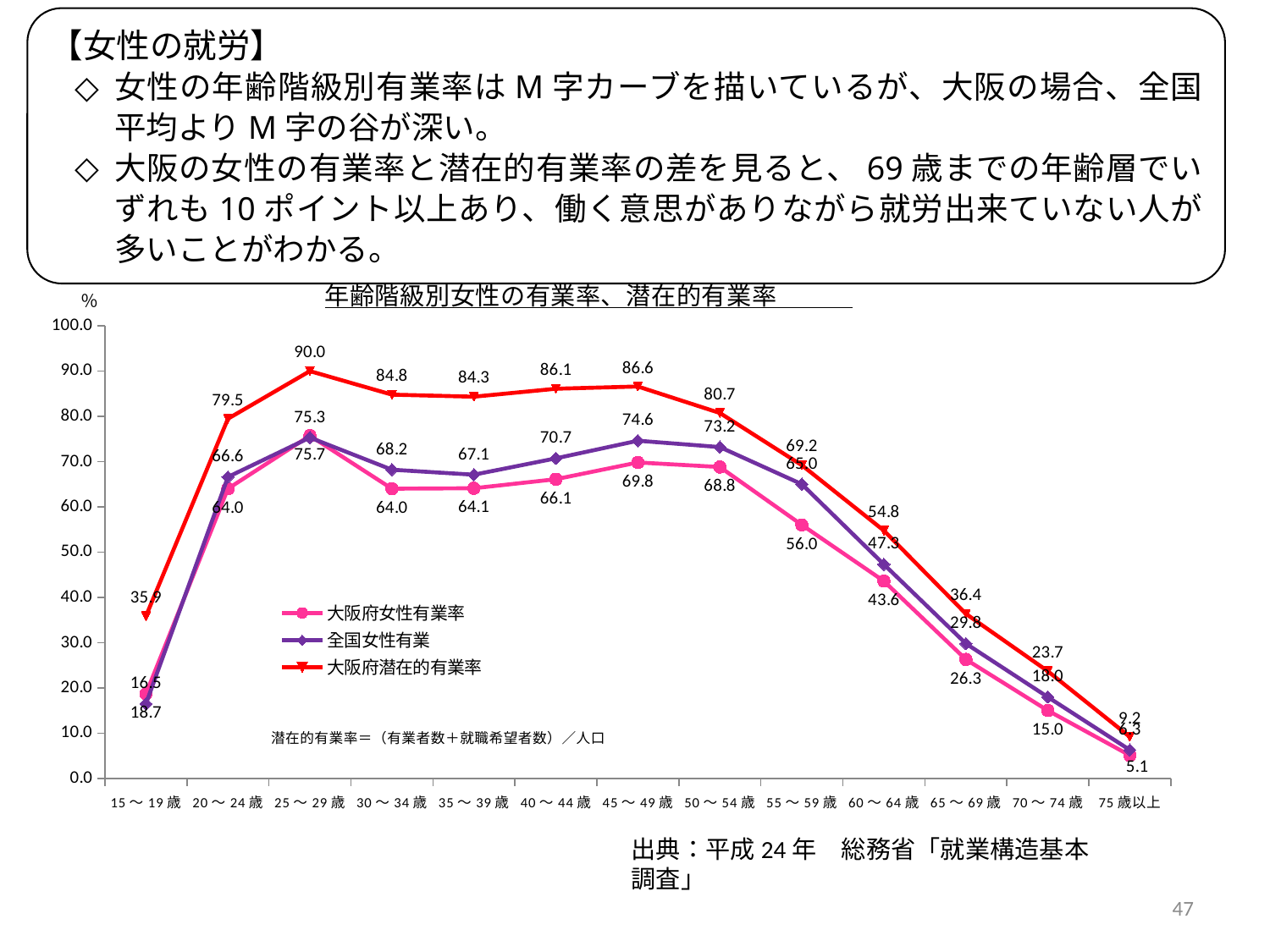
What is the difference between 大阪府潜在的有業率 and 大阪府女性有業率 for 30～34歳? 20.8 What is the title of the chart? 年齢階級別女性の有業率、潜在的有業率 In which age category is 大阪府女性有業率 lowest? 75歳以上 For 50～54歳, which is larger: 全国女性有業 or 大阪府女性有業率? 全国女性有業 In which age category is 大阪府潜在的有業率 highest? 25～29歳 What is the value of 大阪府女性有業率 for 55～59歳? 56.0 What is the value of 全国女性有業 for 60～64歳? 47.3 Does 大阪府潜在的有業率 rise or fall from 45～49歳 to 75歳以上? fall How many age categories are shown on the x axis? 13 What is the value of 大阪府潜在的有業率 for 45～49歳? 86.6 What type of chart is shown on the slide? line chart How many series does the legend list? 3